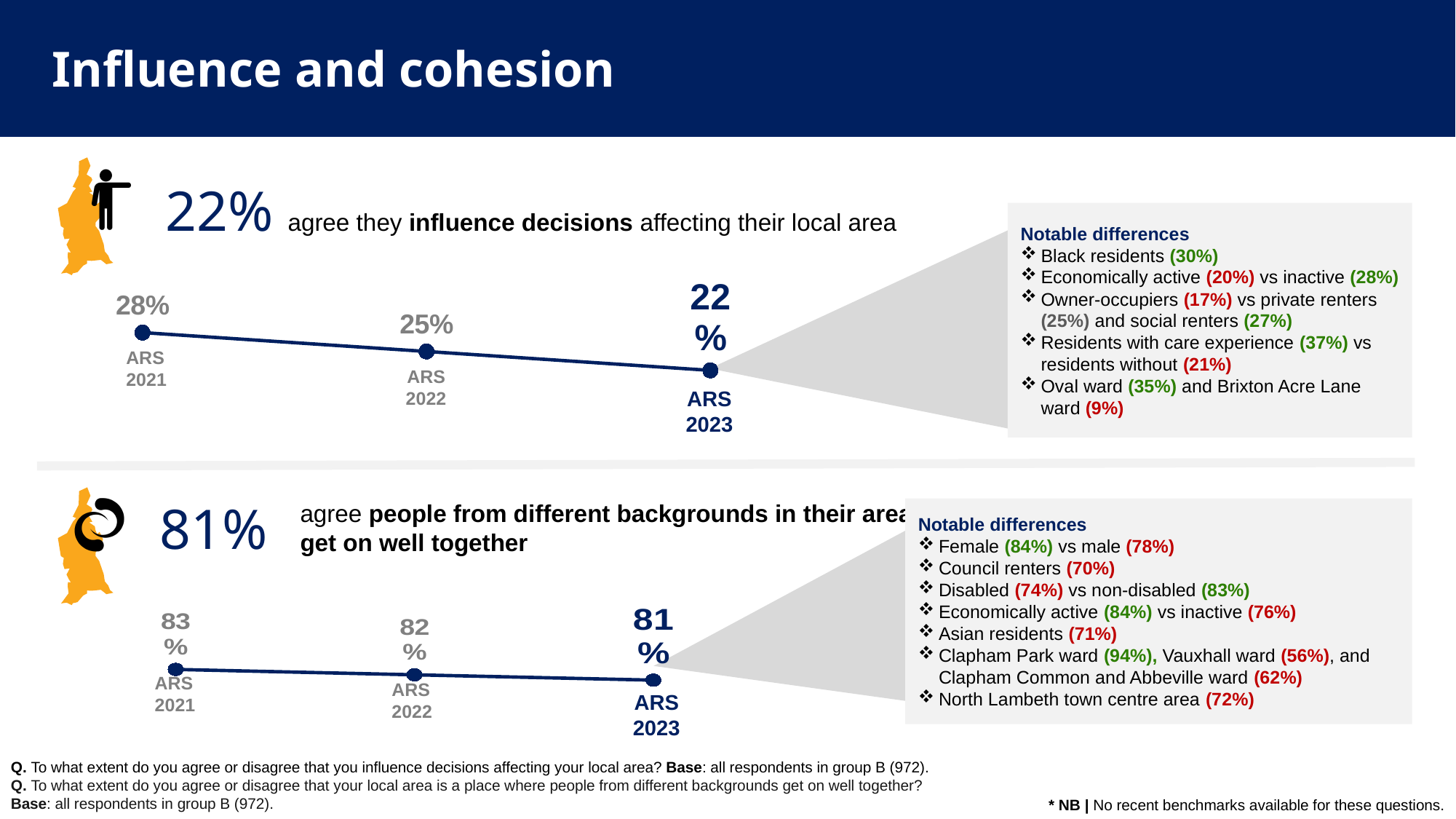
In the top chart (influence decisions), is the value for ARS 2022 larger or smaller than the value for ARS 2023? larger In the top chart (influence decisions), do the values rise or fall from ARS 2021 to ARS 2023? fall In the bottom chart (people from different backgrounds get on well together), what is the value for ARS 2022? 82% In the bottom chart (people from different backgrounds get on well together), which year has the lowest value? ARS 2023 In the top chart (influence decisions), which year has the highest value? ARS 2021 In the top chart (influence decisions), what is the value for ARS 2023? 22% In the top chart (influence decisions), what is the difference between the ARS 2021 and ARS 2023 values? 6 percentage points How many data points are plotted in the top chart (influence decisions)? 3 What type of chart is used for the bottom chart (people from different backgrounds get on well together)? line chart In the bottom chart (people from different backgrounds get on well together), what is the difference between the ARS 2021 and ARS 2023 values? 2 percentage points In the bottom chart (people from different backgrounds get on well together), what is the value for ARS 2021? 83% In the top chart (influence decisions), what is the value for ARS 2021? 28%